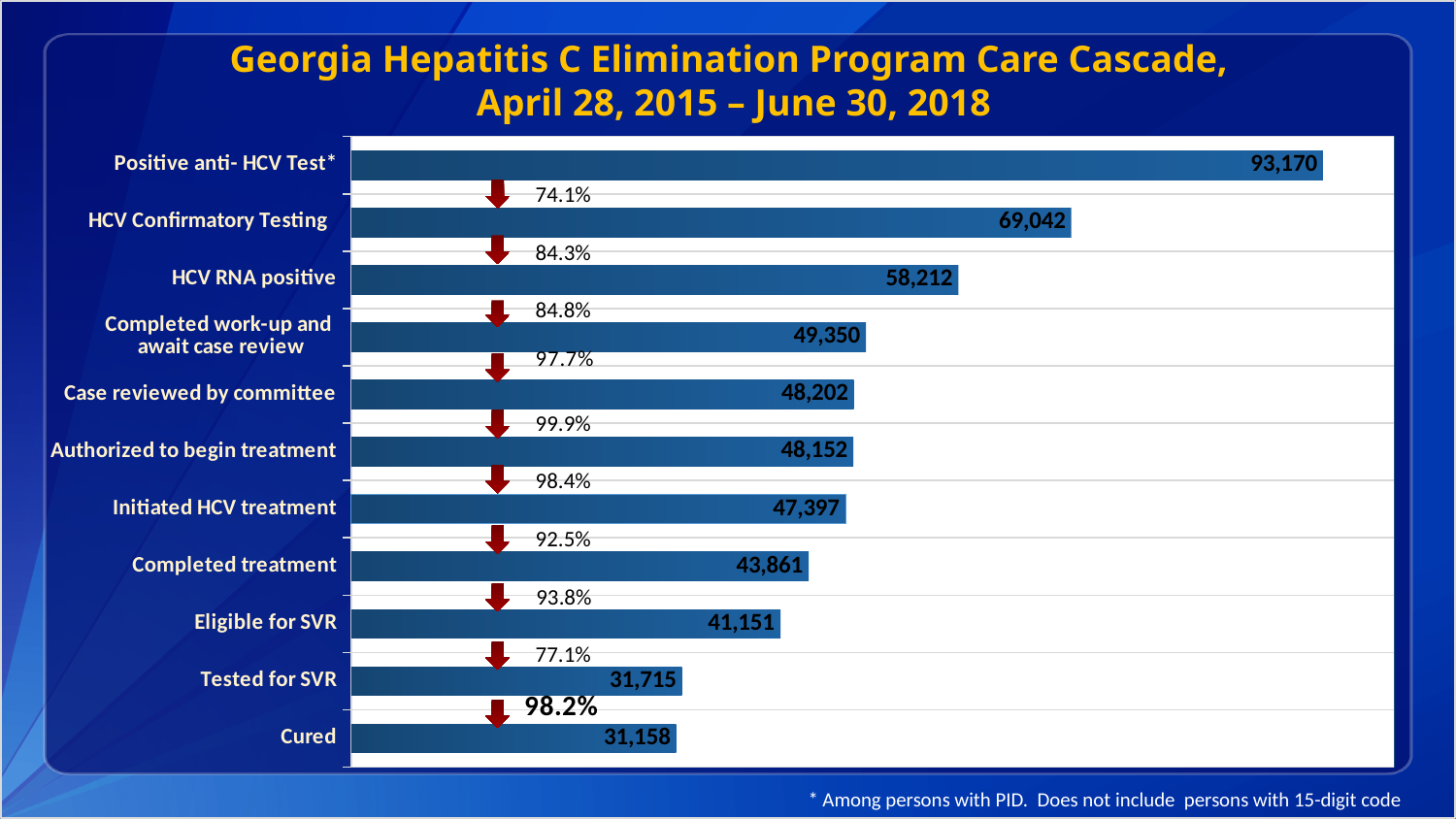
What is the difference between Positive anti-HCV Test and HCV Confirmatory Testing? 24,128 How many categories are shown in the chart? 11 What is the value for Cured? 31,158 What is the value for Initiated HCV treatment? 47,397 What is the difference between Tested for SVR and Cured? 557 Which category has the lowest value? Cured Do the values rise or fall going from the top category to the bottom category? Fall What is the value for Positive anti-HCV Test? 93,170 What percentage is shown between HCV Confirmatory Testing and HCV RNA positive? 84.3% What kind of chart is this? Bar chart Which category has the highest value? Positive anti-HCV Test Which is larger, Completed treatment or Eligible for SVR? Completed treatment